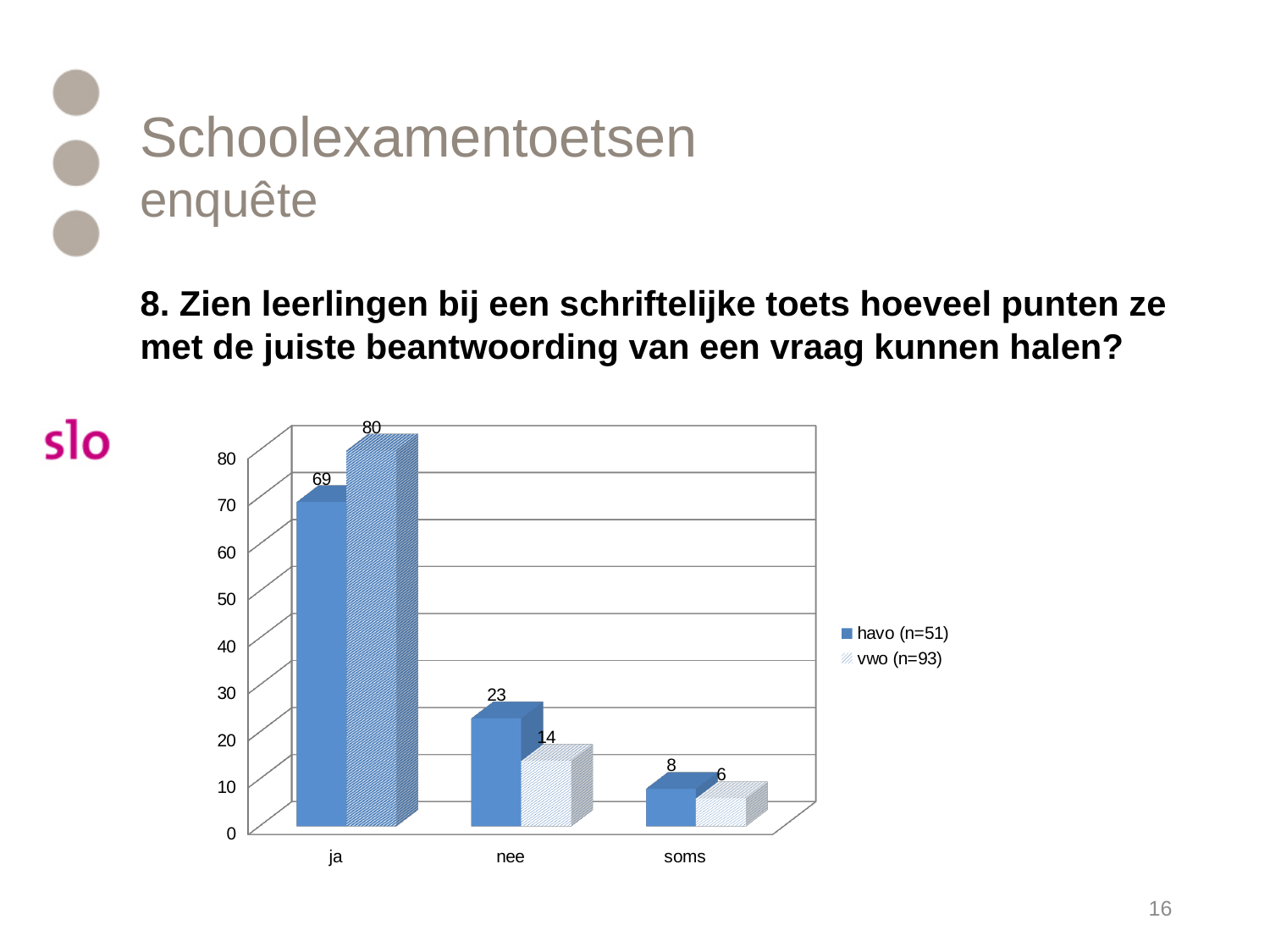
What kind of chart is shown on the slide? bar chart What is the difference between the vwo (n=93) and havo (n=51) values in the 'ja' category? 11 What is the value for vwo (n=93) in the 'ja' category? 80 In the 'nee' category, which series has the larger value, havo (n=51) or vwo (n=93)? havo (n=51) What is the difference between the havo (n=51) and vwo (n=93) values in the 'nee' category? 9 Which category has the highest value for vwo (n=93)? ja Which category has the lowest value for havo (n=51)? soms What is the value for vwo (n=93) in the 'soms' category? 6 How many series does the legend list? 2 What is the value for havo (n=51) in the 'ja' category? 69 What is the value for havo (n=51) in the 'nee' category? 23 How many categories are shown on the x axis? 3